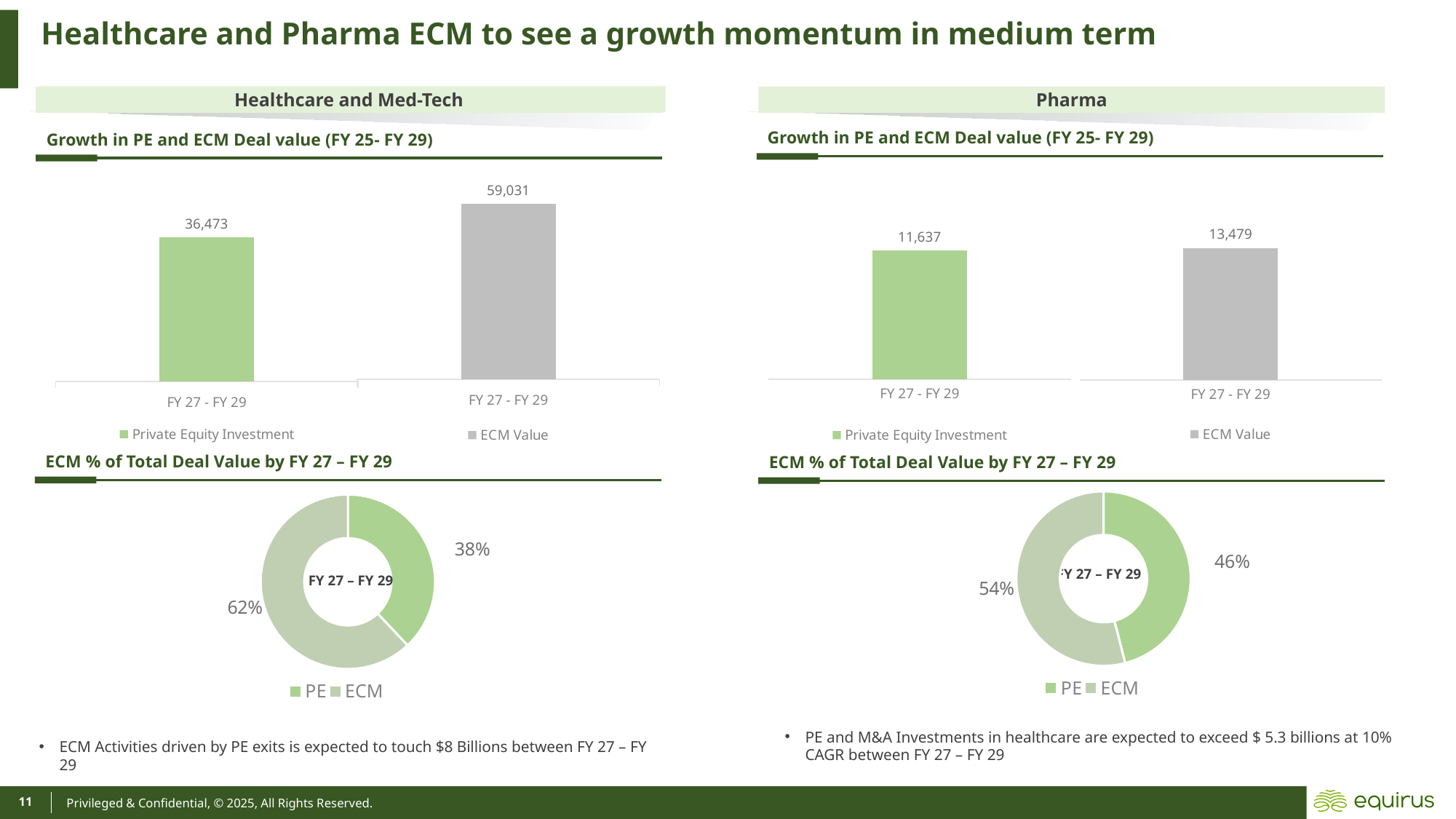
How many series does the legend list in the Healthcare and Med-Tech 'Growth in PE and ECM Deal value' bar chart? 2 In the Pharma 'ECM % of Total Deal Value by FY 27 – FY 29' donut chart, what share does PE have? 46% In the Healthcare and Med-Tech bar chart, which series has the higher value? ECM Value In the Healthcare and Med-Tech 'Growth in PE and ECM Deal value' bar chart, what is the value for Private Equity Investment? 36,473 In the Healthcare and Med-Tech 'ECM % of Total Deal Value by FY 27 – FY 29' donut chart, what share does ECM have? 62% In the Healthcare and Med-Tech 'Growth in PE and ECM Deal value' bar chart, what is the ECM Value? 59,031 In the Pharma bar chart, which is larger: Private Equity Investment or ECM Value? ECM Value In the Pharma 'Growth in PE and ECM Deal value' bar chart, what is the ECM Value? 13,479 In the Pharma 'Growth in PE and ECM Deal value' bar chart, what is the value for Private Equity Investment? 11,637 What type of chart is used for 'ECM % of Total Deal Value by FY 27 – FY 29' under Pharma? Donut (pie) chart In the Pharma bar chart, what is the difference between the ECM Value and the Private Equity Investment? 1,842 In the Healthcare and Med-Tech bar chart, what is the difference between the ECM Value and the Private Equity Investment? 22,558